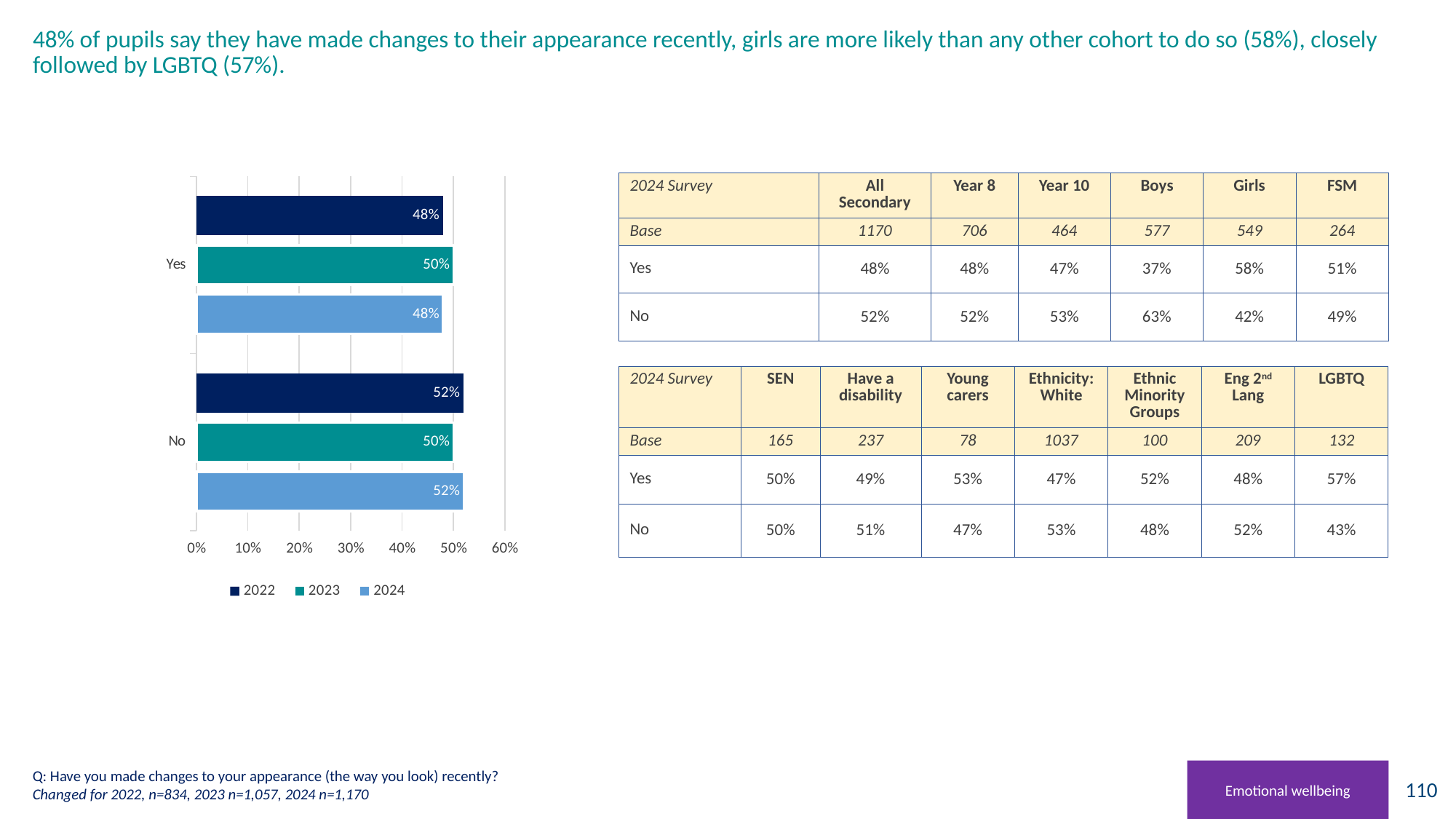
What is the value for Yes in 2022? 48% How many categories are shown on the chart's vertical axis? 2 What is the value for No in 2023? 50% What is the difference between the No and Yes values for 2022? 4% Which year has the highest Yes value? 2023 What is the highest value shown on the chart's horizontal axis? 60% How many series does the chart legend list? 3 Which is larger in 2024, the Yes value or the No value? No Which year has the lowest No value? 2023 What is the value for Yes in 2023? 50% What kind of chart is shown on the slide? bar chart What is the value for No in 2024? 52%